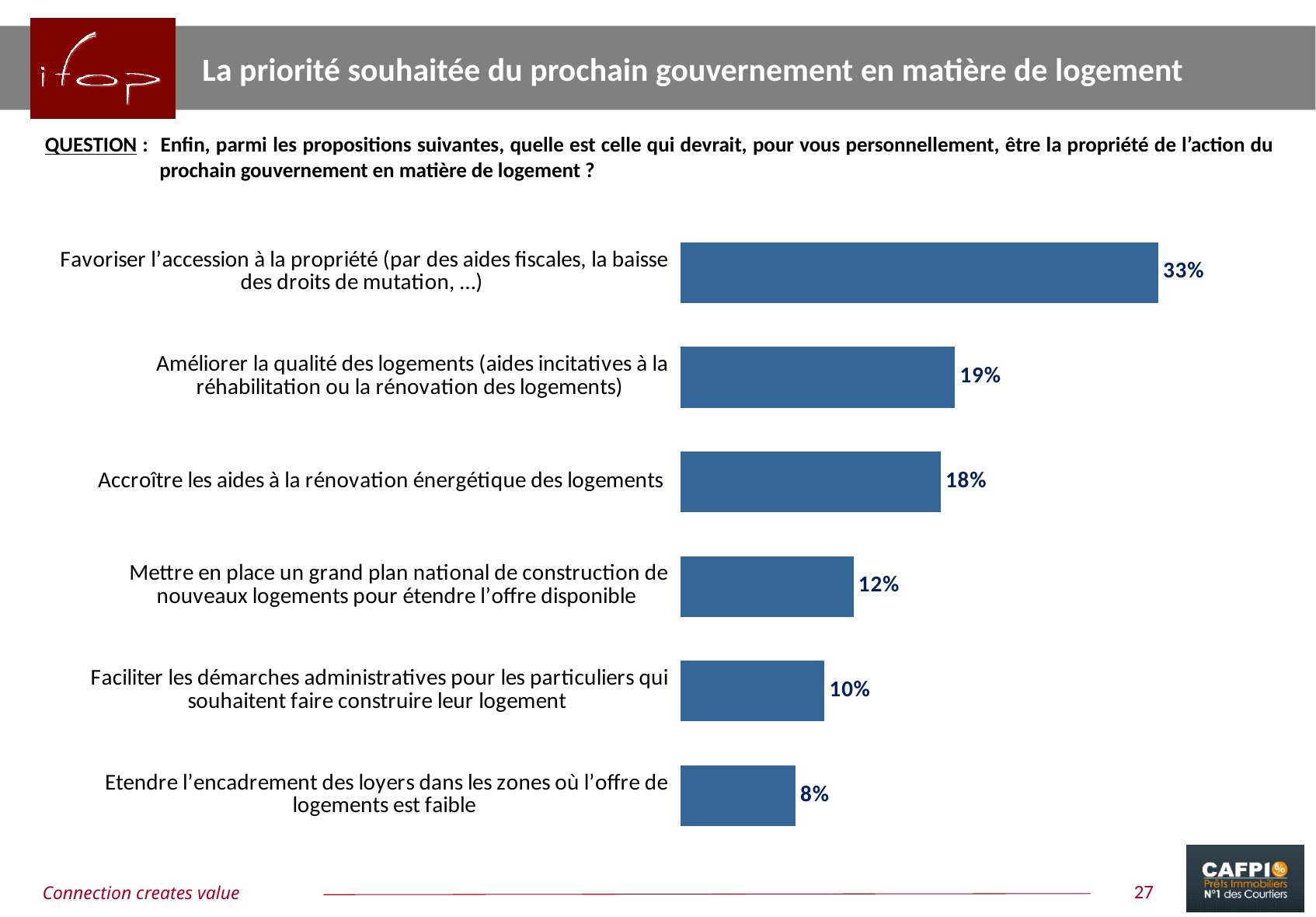
Which has a larger value: "Améliorer la qualité des logements" or "Accroître les aides à la rénovation énergétique des logements"? Améliorer la qualité des logements How many propositions are shown in the chart? 6 What is the title of the slide? La priorité souhaitée du prochain gouvernement en matière de logement What is the difference between the value for "Favoriser l'accession à la propriété" and the value for "Améliorer la qualité des logements"? 14 percentage points What is the value for "Faciliter les démarches administratives pour les particuliers qui souhaitent faire construire leur logement"? 10% What is the value for "Accroître les aides à la rénovation énergétique des logements"? 18% What is the value for "Etendre l'encadrement des loyers dans les zones où l'offre de logements est faible"? 8% Which proposition has the highest percentage? Favoriser l'accession à la propriété (par des aides fiscales, la baisse des droits de mutation, ...) What is the difference between the value for "Mettre en place un grand plan national de construction" and the value for "Etendre l'encadrement des loyers"? 4 percentage points Which proposition has the lowest percentage? Etendre l'encadrement des loyers dans les zones où l'offre de logements est faible What percentage of respondents chose "Favoriser l'accession à la propriété" as the priority? 33% What kind of chart is shown on the slide? Bar chart